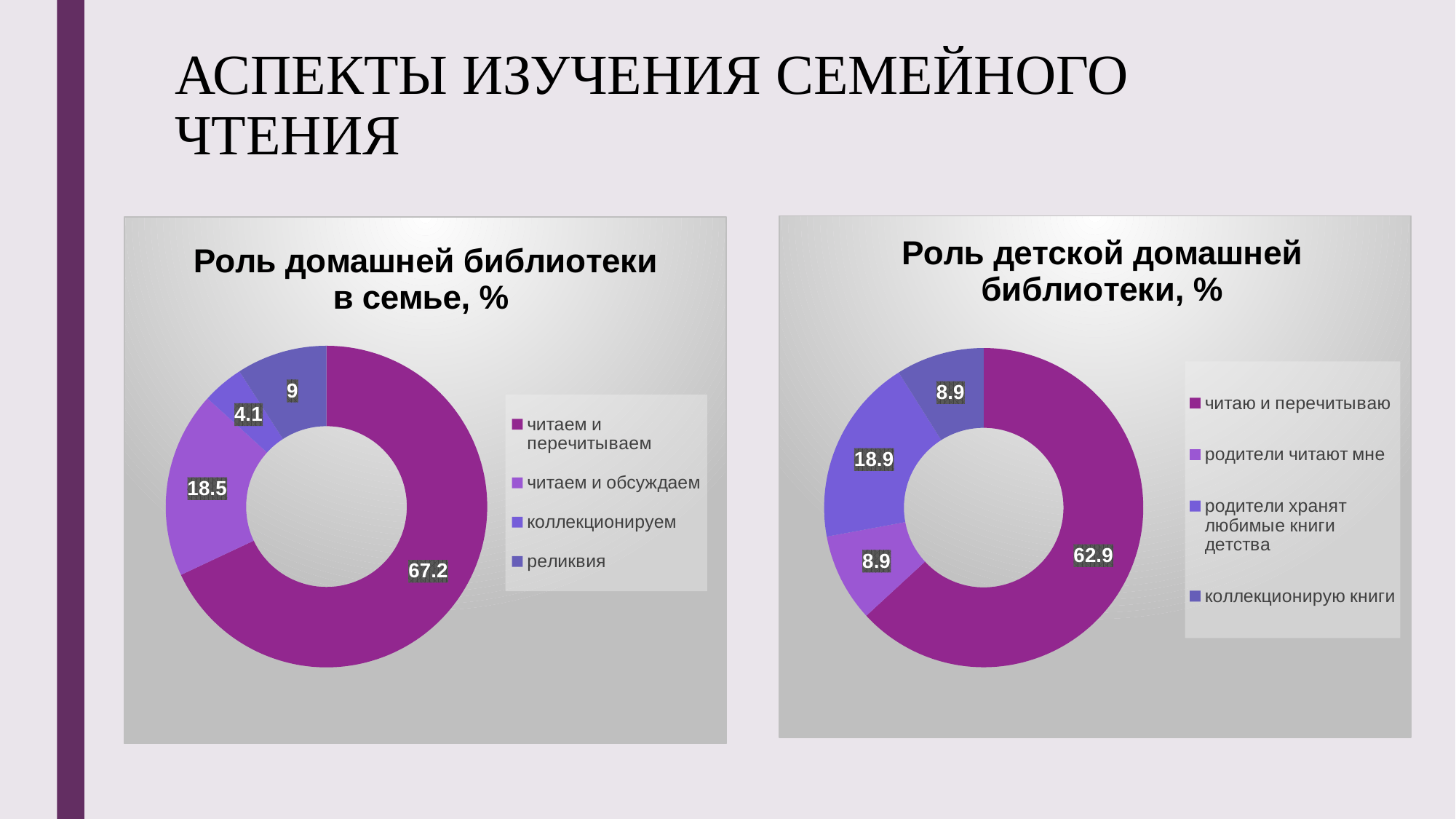
In the chart 'Роль детской домашней библиотеки, %', what is the value for 'читаю и перечитываю'? 62.9 In the chart 'Роль домашней библиотеки в семье, %', what is the value for 'читаем и перечитываем'? 67.2 In the chart 'Роль детской домашней библиотеки, %', which category has the largest share? читаю и перечитываю In the chart 'Роль детской домашней библиотеки, %', what is the value for 'родители хранят любимые книги детства'? 18.9 In the chart 'Роль детской домашней библиотеки, %', which is larger: 'родители хранят любимые книги детства' or 'коллекционирую книги'? родители хранят любимые книги детства In the chart 'Роль домашней библиотеки в семье, %', which category has the smallest share? коллекционируем How many legend entries does the chart 'Роль детской домашней библиотеки, %' list? 4 In the chart 'Роль домашней библиотеки в семье, %', what is the difference between 'читаем и обсуждаем' and 'реликвия'? 9.5 What type of chart is 'Роль домашней библиотеки в семье, %'? doughnut chart In the chart 'Роль домашней библиотеки в семье, %', how many categories are shown? 4 In the chart 'Роль домашней библиотеки в семье, %', what is the value for 'коллекционируем'? 4.1 In the chart 'Роль детской домашней библиотеки, %', what is the difference between 'читаю и перечитываю' and 'родители читают мне'? 54